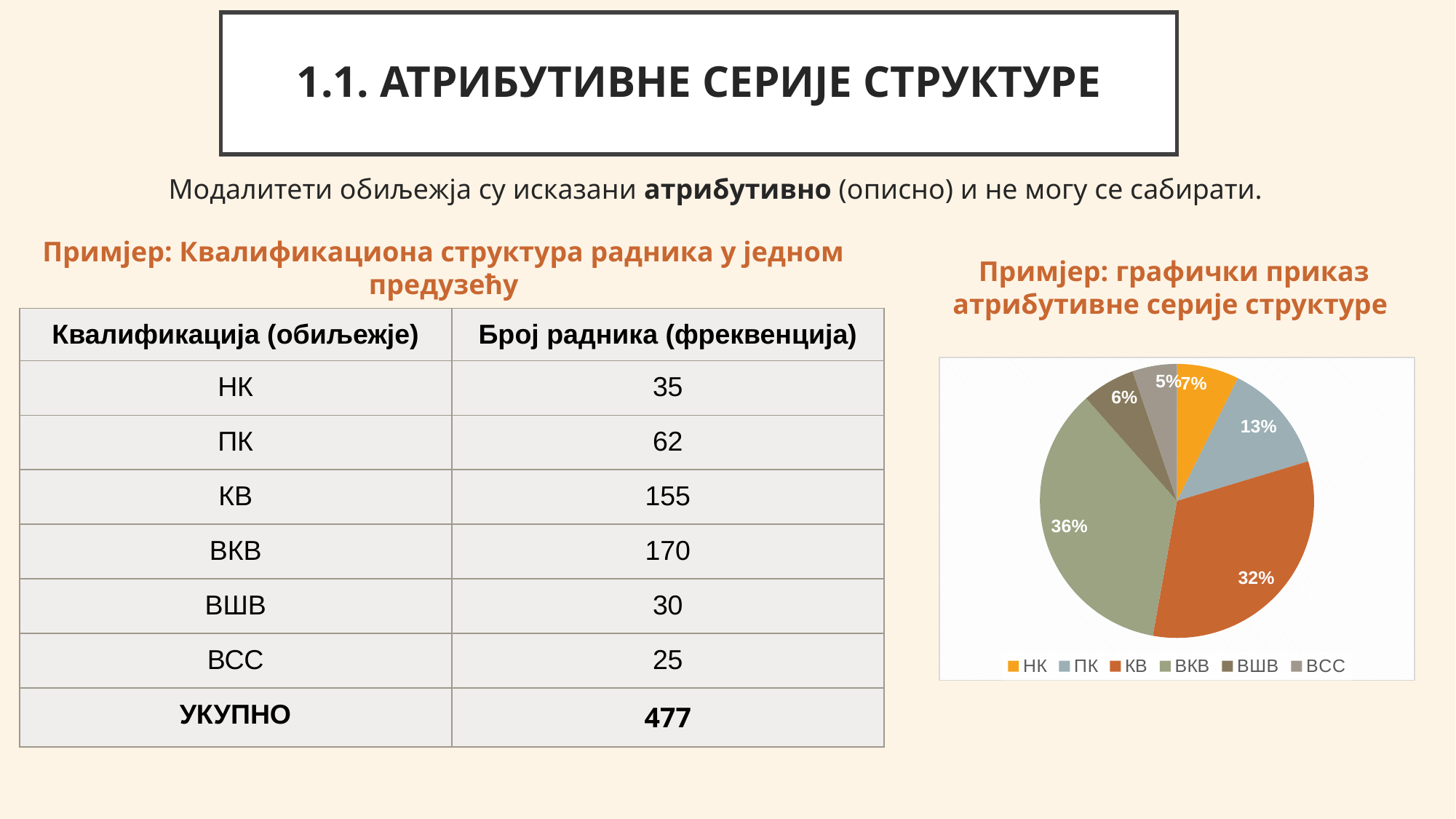
Which slice is larger, ПК or КВ? КВ What share of the pie does the НК slice represent? 7% What share of the pie does the ПК slice represent? 13% Which category has the largest slice of the pie? ВКВ What share of the pie does the КВ slice represent? 32% Which category has the smallest slice of the pie? ВСС Which category is shown in orange-yellow in the pie chart legend? НК What kind of chart is shown on the slide? pie chart How many slices does the pie chart have? 6 By how many percentage points does the ВКВ slice exceed the КВ slice? 4